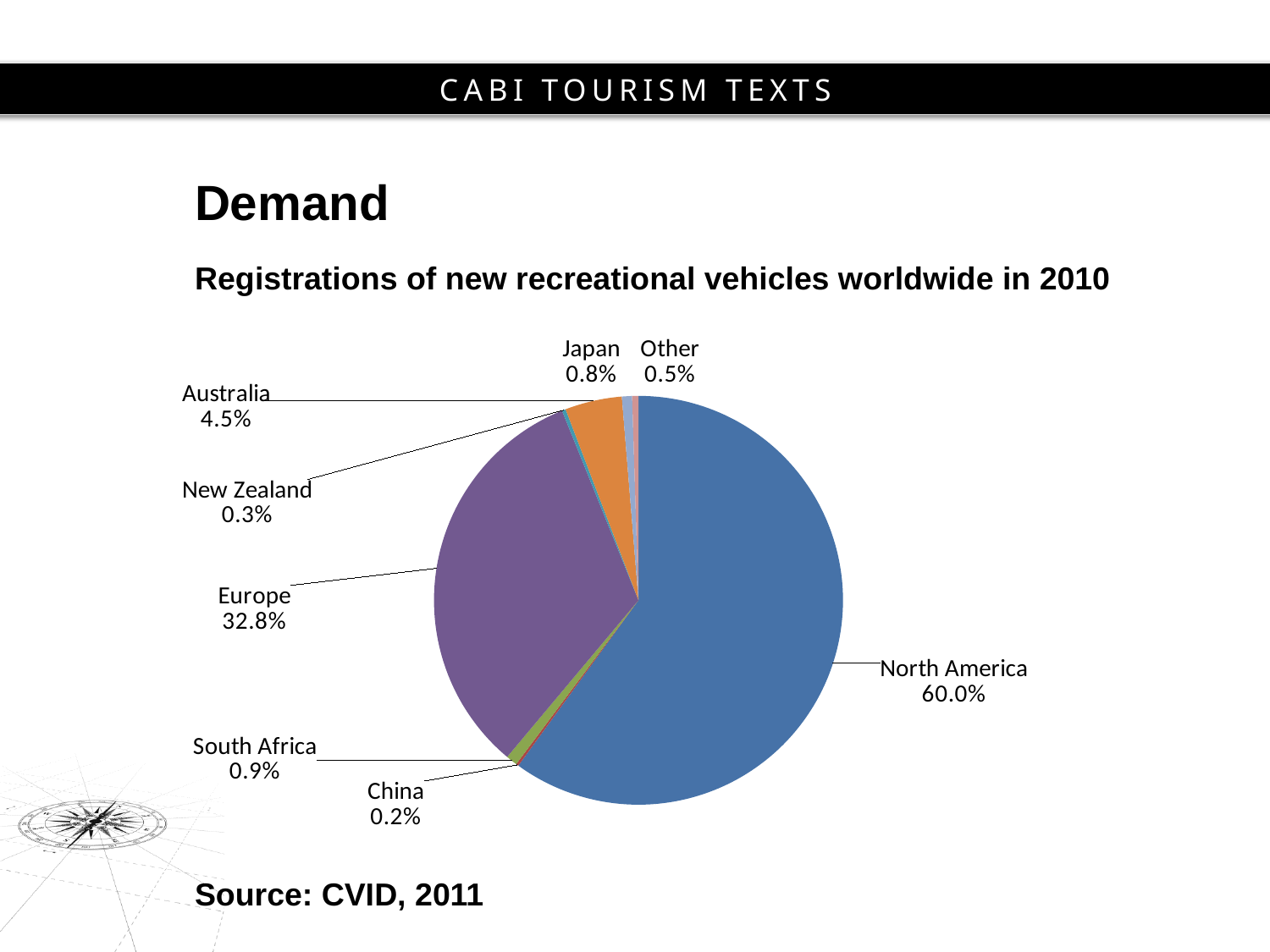
Which region has the largest slice of the pie? North America What is the value shown for Europe? 32.8% Which is larger, the share for South Africa or the share for Japan? South Africa What kind of chart is shown on the slide? Pie chart What share of new recreational vehicle registrations in 2010 does North America account for? 60.0% What percentage is shown for Australia? 4.5% What is the value shown for Japan? 0.8% What is the combined share of Australia and New Zealand? 4.8% What is the difference in percentage points between North America and Europe? 27.2 percentage points What is the title of the chart? Registrations of new recreational vehicles worldwide in 2010 How many slices does the pie chart have? 8 Which region has the smallest slice of the pie? China